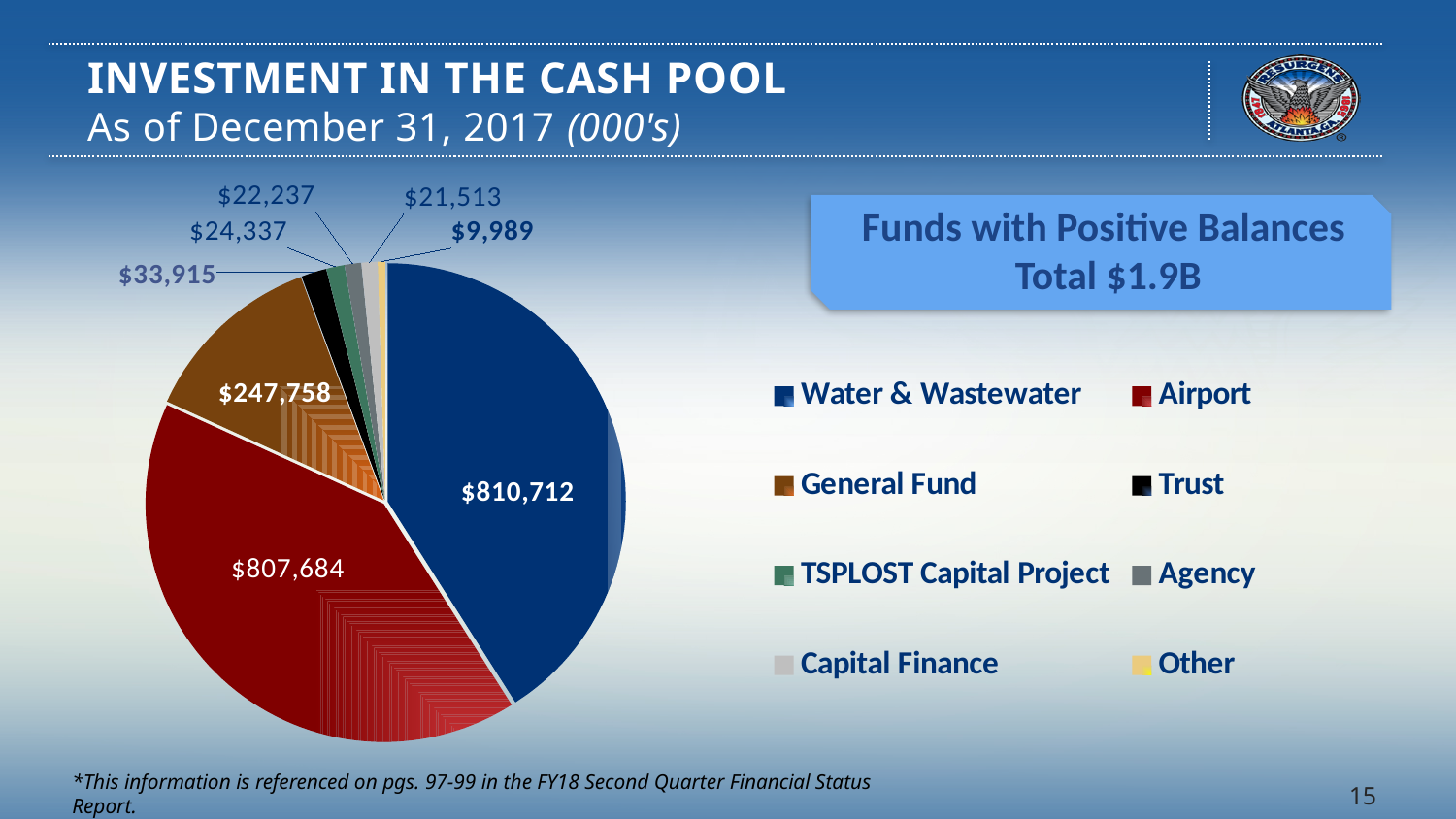
What is the value for General Fund in the pie chart? $247,758 What is the value for Water & Wastewater in the pie chart? $810,712 Which category has the smallest slice in the pie chart? Other Which is larger, the Airport value or the General Fund value? Airport Which category has the largest slice in the pie chart? Water & Wastewater What is the difference between the Water & Wastewater value and the General Fund value? $562,954 What type of chart is shown on the slide? Pie chart What is the title of the chart on the slide? INVESTMENT IN THE CASH POOL According to the callout on the slide, what is the total of funds with positive balances? $1.9B How many categories does the legend of the pie chart list? 8 What is the value for Airport in the pie chart? $807,684 What is the difference between the Water & Wastewater value and the Airport value? $3,028